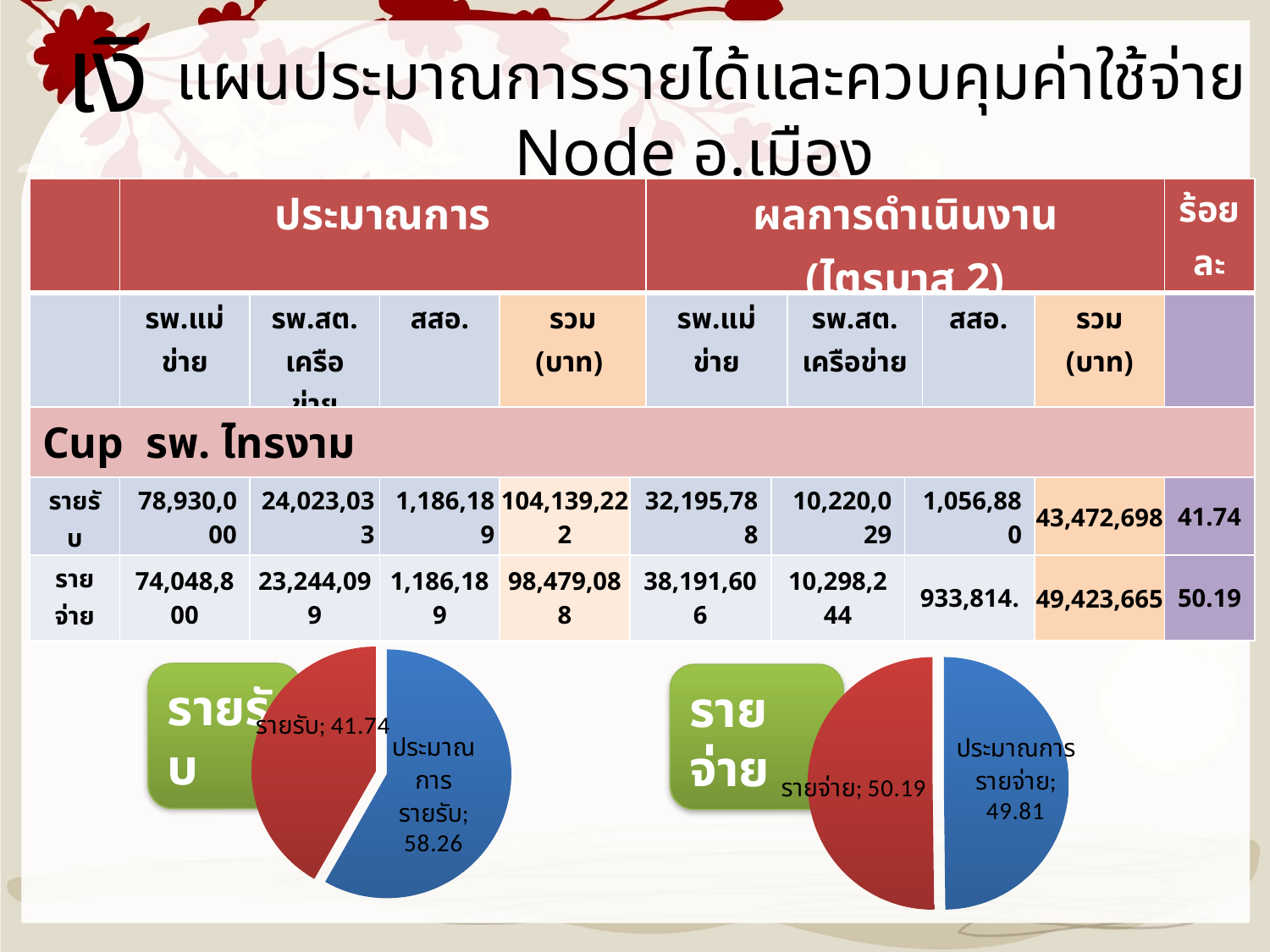
In the left pie chart (รายรับ), what colour is the slice labelled รายรับ? red In the right pie chart (รายจ่าย), what value is shown for the slice labelled ประมาณการรายจ่าย? 49.81 In the left pie chart (รายรับ), what value is shown for the slice labelled ประมาณการรายรับ? 58.26 In the left pie chart (รายรับ), what value is shown for the slice labelled รายรับ? 41.74 What kind of chart is shown on the left side of the slide, next to the green รายรับ label? pie chart In the right pie chart (รายจ่าย), which slice has the smaller value, รายจ่าย or ประมาณการรายจ่าย? ประมาณการรายจ่าย In the right pie chart (รายจ่าย), what is the difference between the รายจ่าย slice and the ประมาณการรายจ่าย slice? 0.38 In the left pie chart (รายรับ), which slice is larger? ประมาณการรายรับ How many slices does the left pie chart (รายรับ) have? 2 How many pie charts are shown on the slide? 2 In the left pie chart (รายรับ), what is the difference between the ประมาณการรายรับ slice and the รายรับ slice? 16.52 In the right pie chart (รายจ่าย), what value is shown for the slice labelled รายจ่าย? 50.19